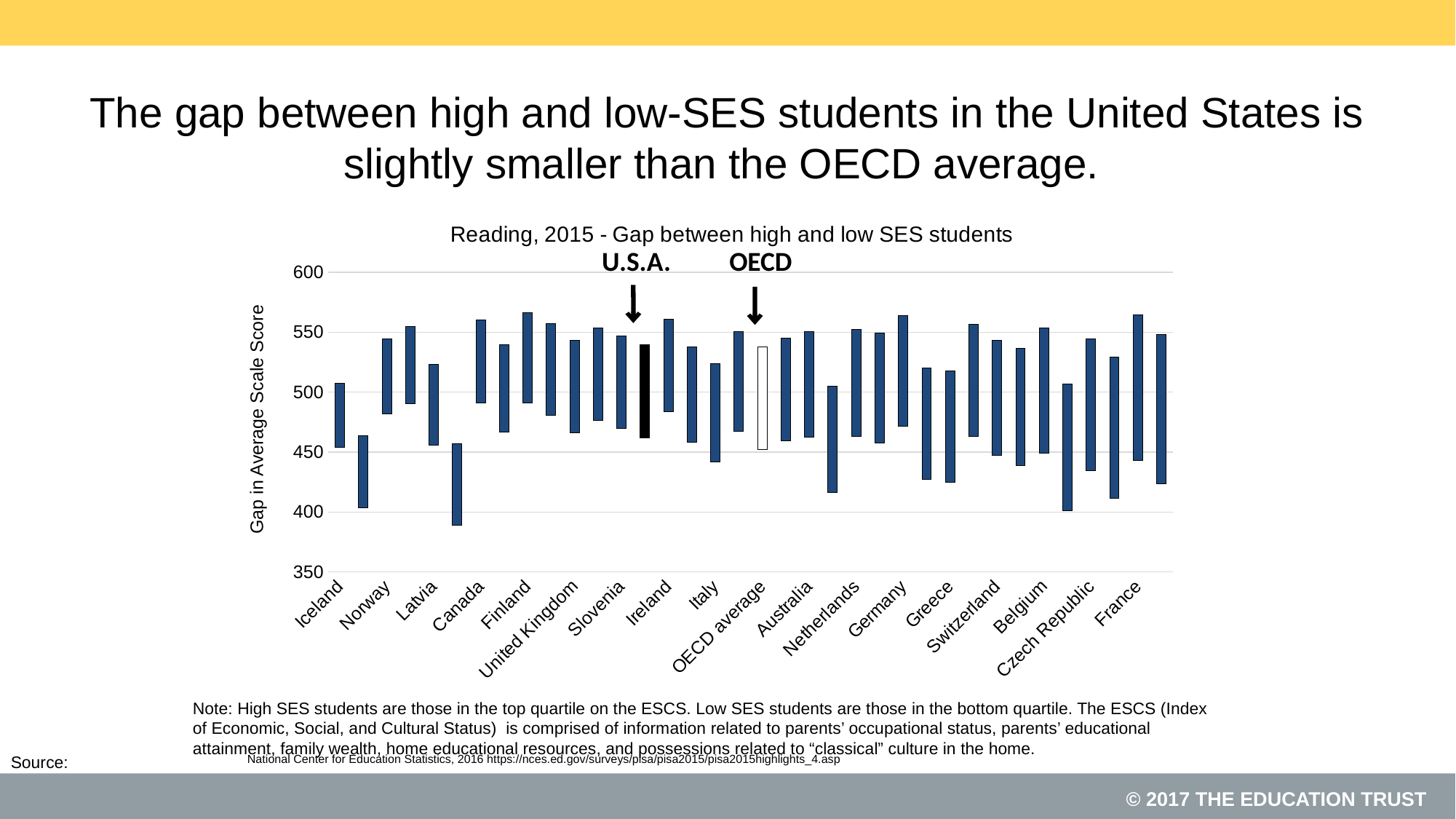
Is the top of the bar for Iceland greater or less than 550? less Is the top of the bar marked U.S.A. greater or less than 550? less Is the top of the bar marked U.S.A. greater or less than 500? greater What type of chart is shown on the slide? Bar chart What is the label on the vertical axis of the chart? Gap in Average Scale Score What is the highest value shown on the vertical axis? 600 What is the title of the chart? Reading, 2015 - Gap between high and low SES students